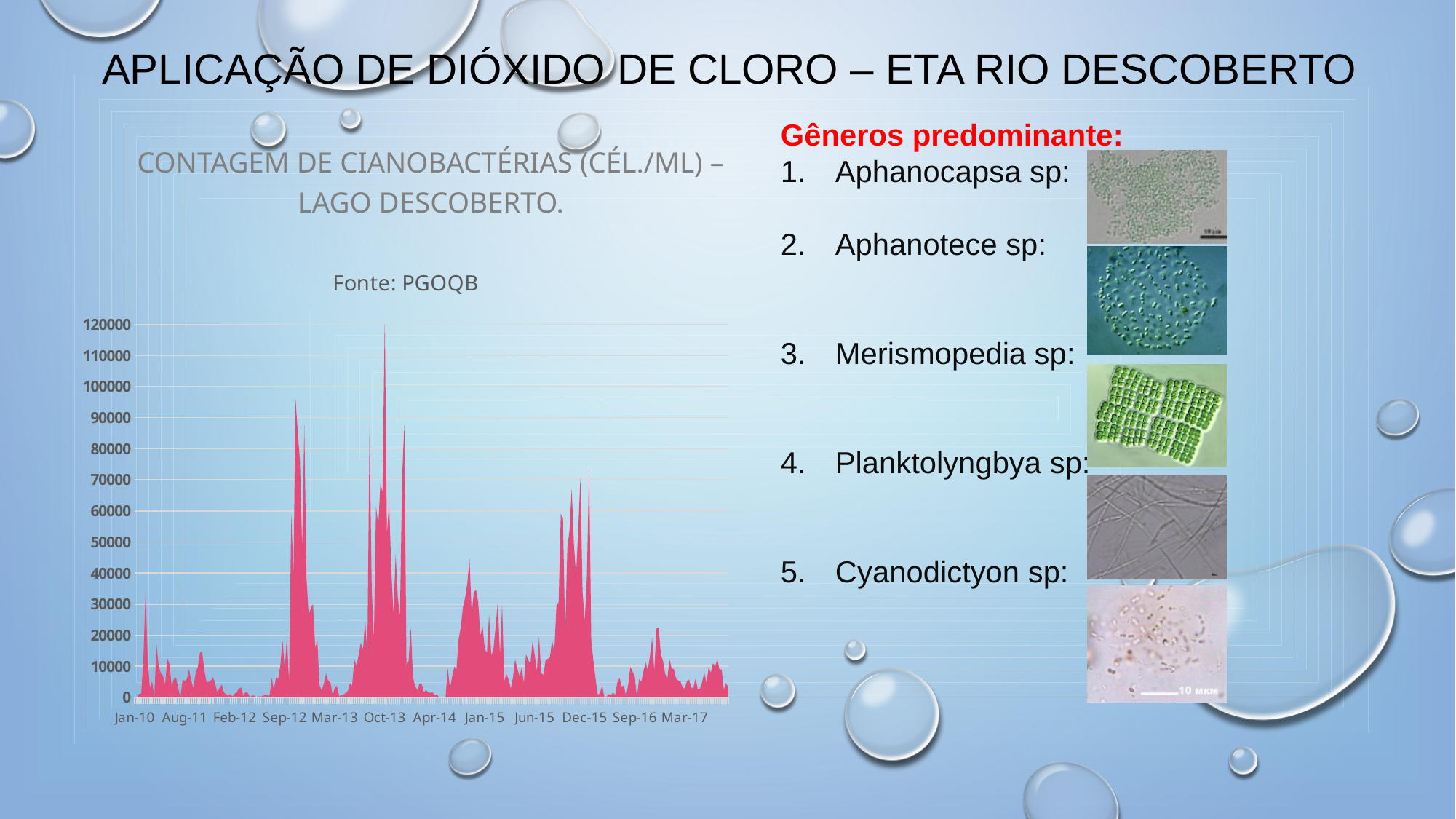
Is the highest peak of the chart, near Oct-13, greater or less than 100000? greater What source is cited below the chart title? PGOQB What is the first date label on the horizontal axis? Jan-10 Is the peak near Sep-12 greater or less than 80000? greater How many date labels are shown along the horizontal axis of the chart? 12 Which peak is higher: the one near Sep-12 or the one near Sep-16? Sep-12 Is the peak near Mar-17 greater or less than 30000? less What is the last date label on the horizontal axis? Mar-17 What is the highest value shown on the vertical axis of the chart? 120000 What is the title of the chart? Contagem de cianobactérias (cél./mL) – Lago Descoberto. Around which date label does the chart reach its highest peak? Oct-13 What kind of chart is shown on the slide? area chart